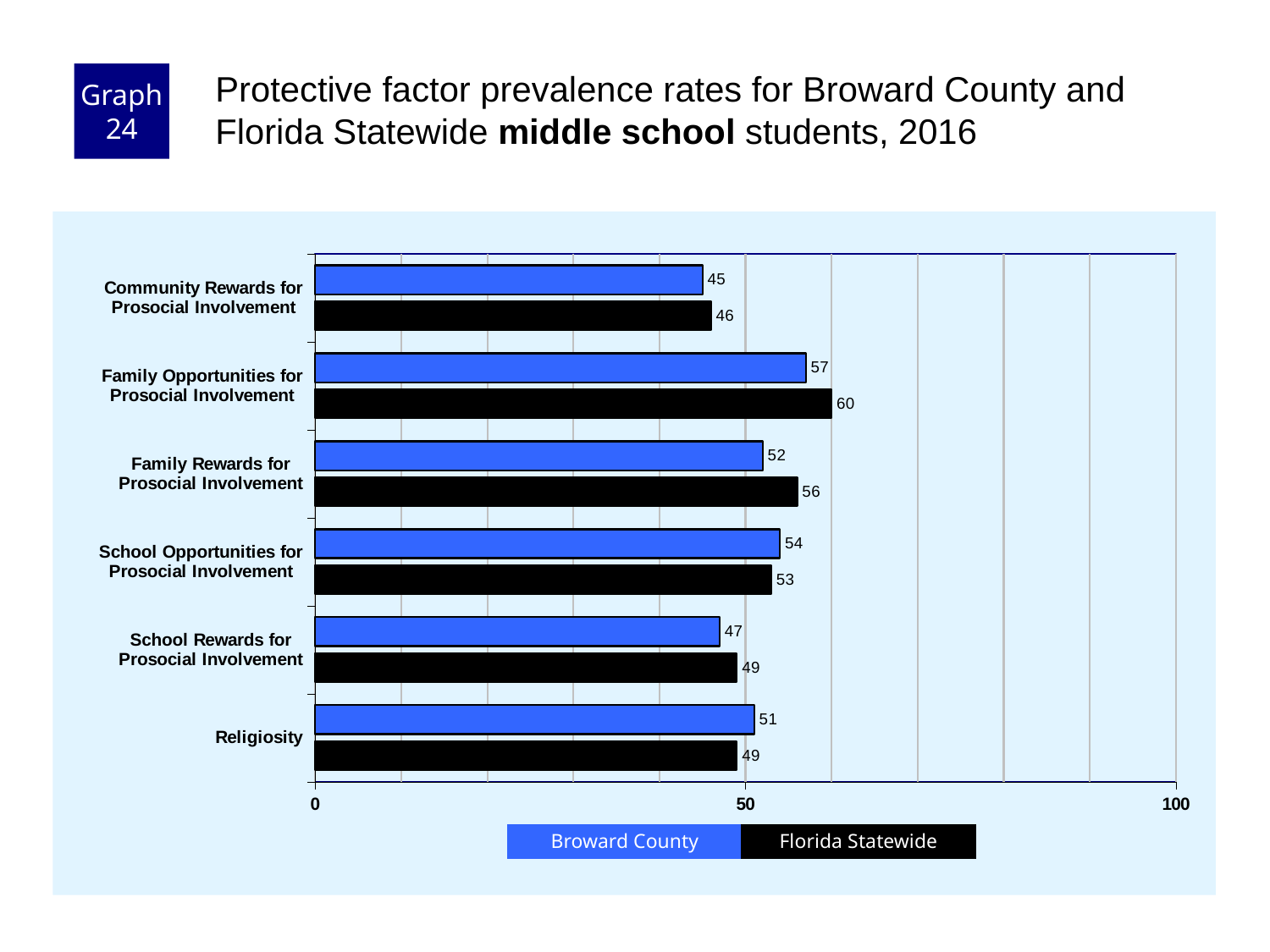
Which colour represents Florida Statewide in the chart? Black How many protective factor categories are shown on the chart? 6 What kind of chart is shown on the slide? Bar chart What is the Florida Statewide value for Family Rewards for Prosocial Involvement? 56 Which category has the lowest Broward County value? Community Rewards for Prosocial Involvement How many series does the legend list? 2 For School Opportunities for Prosocial Involvement, which is larger: Broward County or Florida Statewide? Broward County What is the difference between the Florida Statewide and Broward County values for Family Rewards for Prosocial Involvement? 4 What is the Broward County value for Religiosity? 51 Which category has the highest Florida Statewide value? Family Opportunities for Prosocial Involvement Is the Florida Statewide value for Family Opportunities for Prosocial Involvement greater or less than 50? greater What is the Broward County value for Family Opportunities for Prosocial Involvement? 57